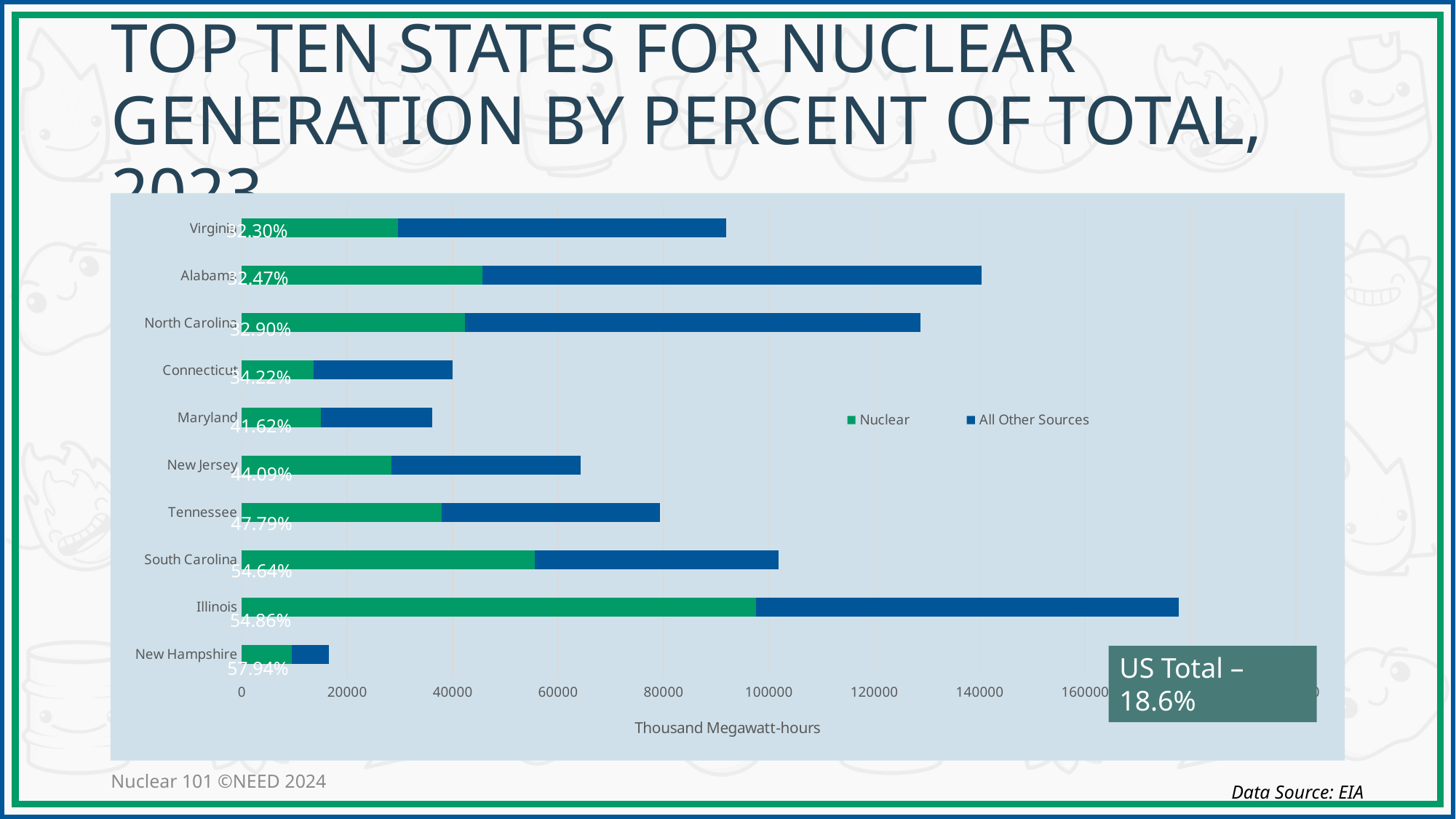
Which state has a longer total bar, Alabama or Virginia? Alabama What is the x-axis title of the chart? Thousand Megawatt-hours Is the total bar for Illinois greater or less than 160000 thousand megawatt-hours? greater What nuclear percentage is labeled for Virginia? 32.30% How many series does the legend list? 2 Which state has the longest total bar (largest total generation)? Illinois What type of chart is shown on the slide? Stacked bar chart Is the total bar for Connecticut greater or less than 60000 thousand megawatt-hours? less Which state has the shortest total bar (smallest total generation)? New Hampshire What nuclear percentage is labeled for New Hampshire? 57.94% How many states are shown in the chart? 10 What nuclear percentage is labeled for Illinois? 54.86%